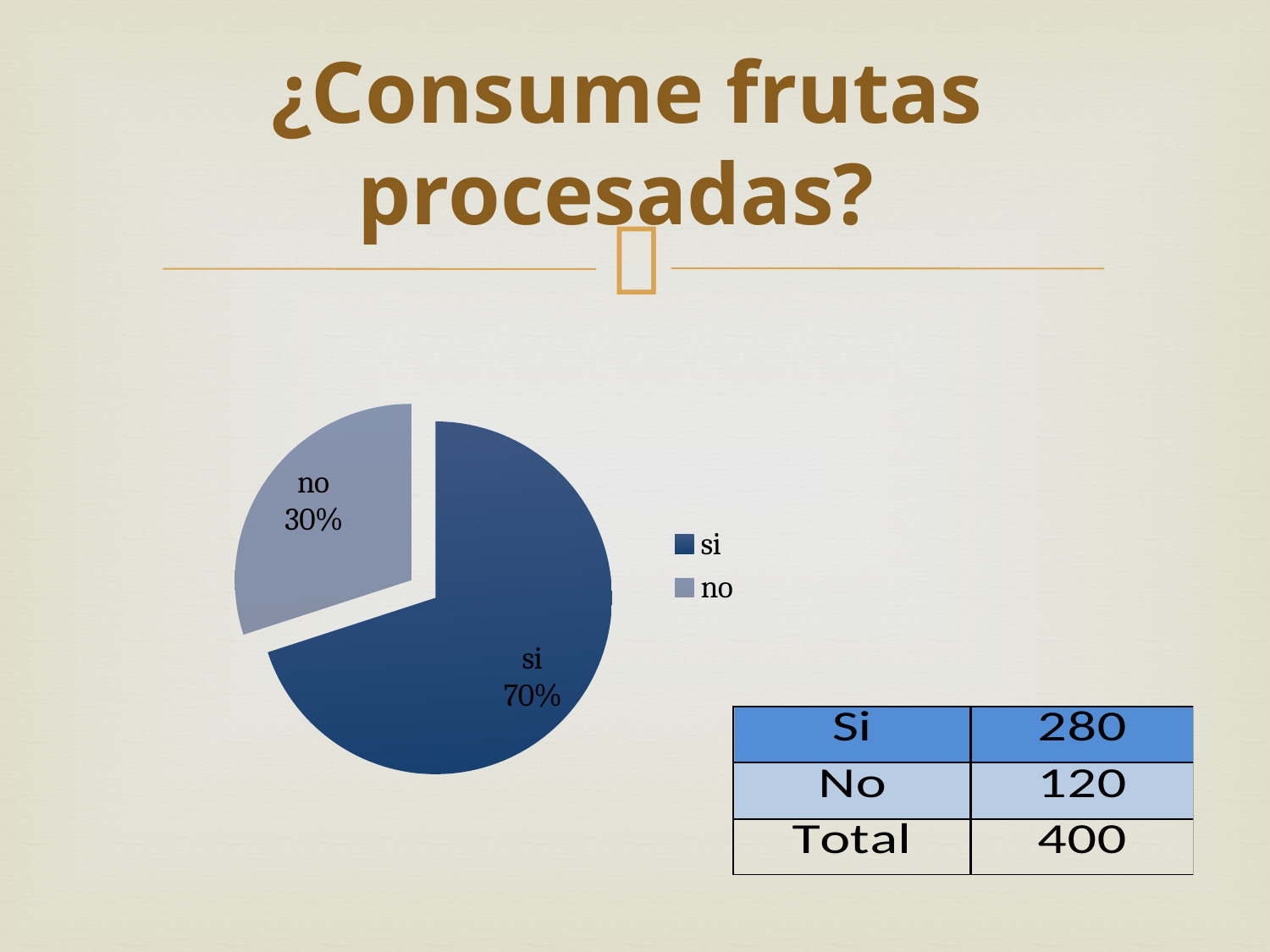
What percentage of the pie chart is labelled "no"? 30% Which slice is larger, "si" or "no"? si How many slices does the pie chart have? 2 What is the title of the slide containing the pie chart? ¿Consume frutas procesadas? How many entries does the legend list? 2 What percentage of the pie chart is labelled "si"? 70% What is the difference in percentage points between the "si" and "no" slices? 40 Which slice of the pie chart is the smallest? no Is the share of the "no" slice greater or less than 50%? less Which slice of the pie chart is pulled out (exploded) from the rest? no Which slice of the pie chart is the largest? si What kind of chart is shown on the slide? pie chart